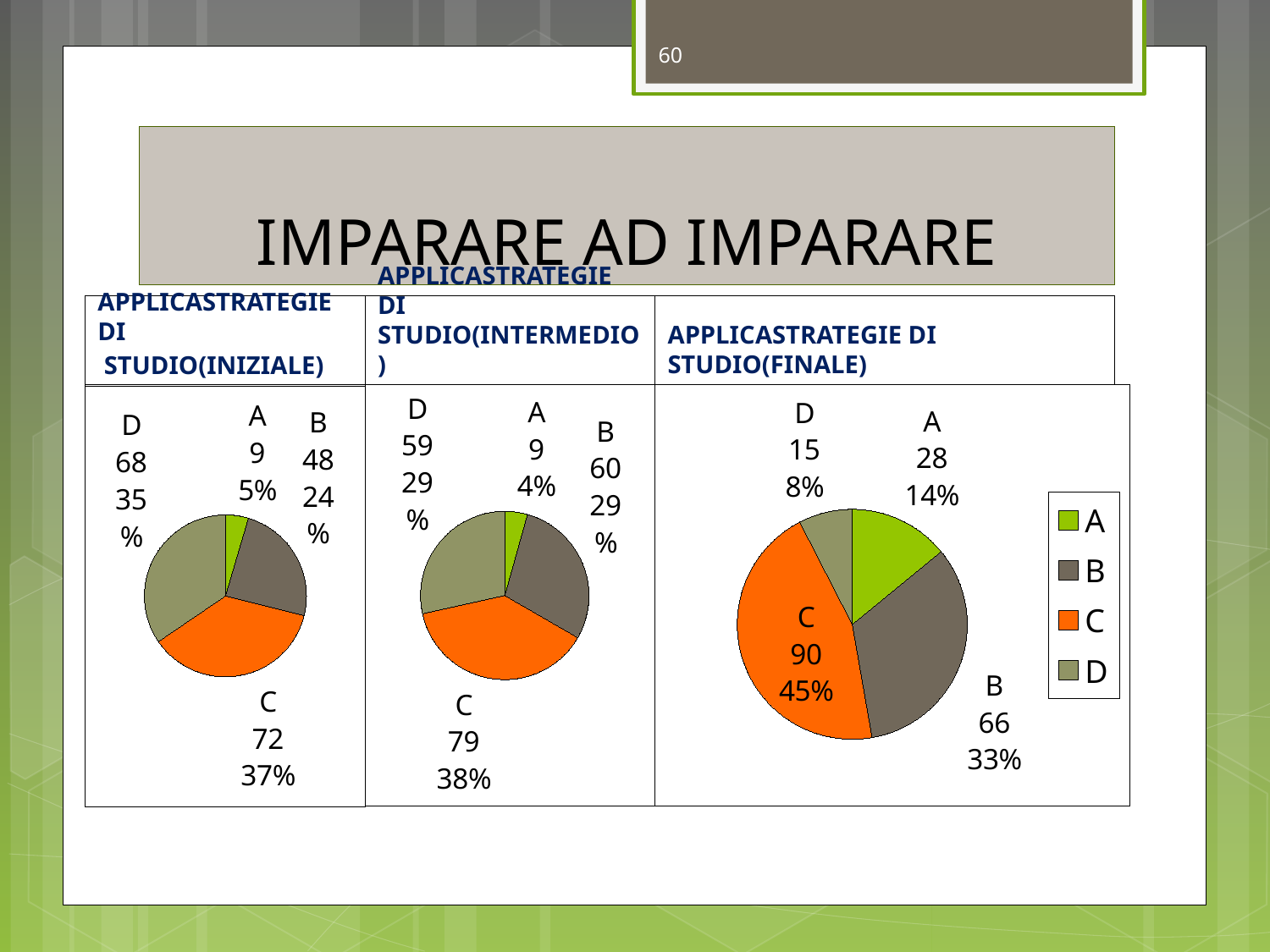
What type of chart is used in the APPLICASTRATEGIE DI STUDIO(FINALE) panel? Pie chart In the APPLICASTRATEGIE DI STUDIO(INTERMEDIO) chart, which category has the largest slice? C How many categories does the legend on the right of the slide list? 4 In the APPLICASTRATEGIE DI STUDIO(INIZIALE) chart, what value is shown for category C? 72 In the APPLICASTRATEGIE DI STUDIO(INIZIALE) chart, what percentage share does category D have? 35% In the APPLICASTRATEGIE DI STUDIO(INIZIALE) chart, which category has the smallest slice? A In the APPLICASTRATEGIE DI STUDIO(FINALE) chart, which is larger, the value for B or the value for D? B In the APPLICASTRATEGIE DI STUDIO(FINALE) chart, what value is shown for category A? 28 In the APPLICASTRATEGIE DI STUDIO(FINALE) chart, what is the difference between the values for C and B? 24 In the APPLICASTRATEGIE DI STUDIO(INTERMEDIO) chart, what percentage share does category C have? 38% In the APPLICASTRATEGIE DI STUDIO(FINALE) chart, what percentage share does category C have? 45% In the APPLICASTRATEGIE DI STUDIO(INTERMEDIO) chart, what value is shown for category B? 60